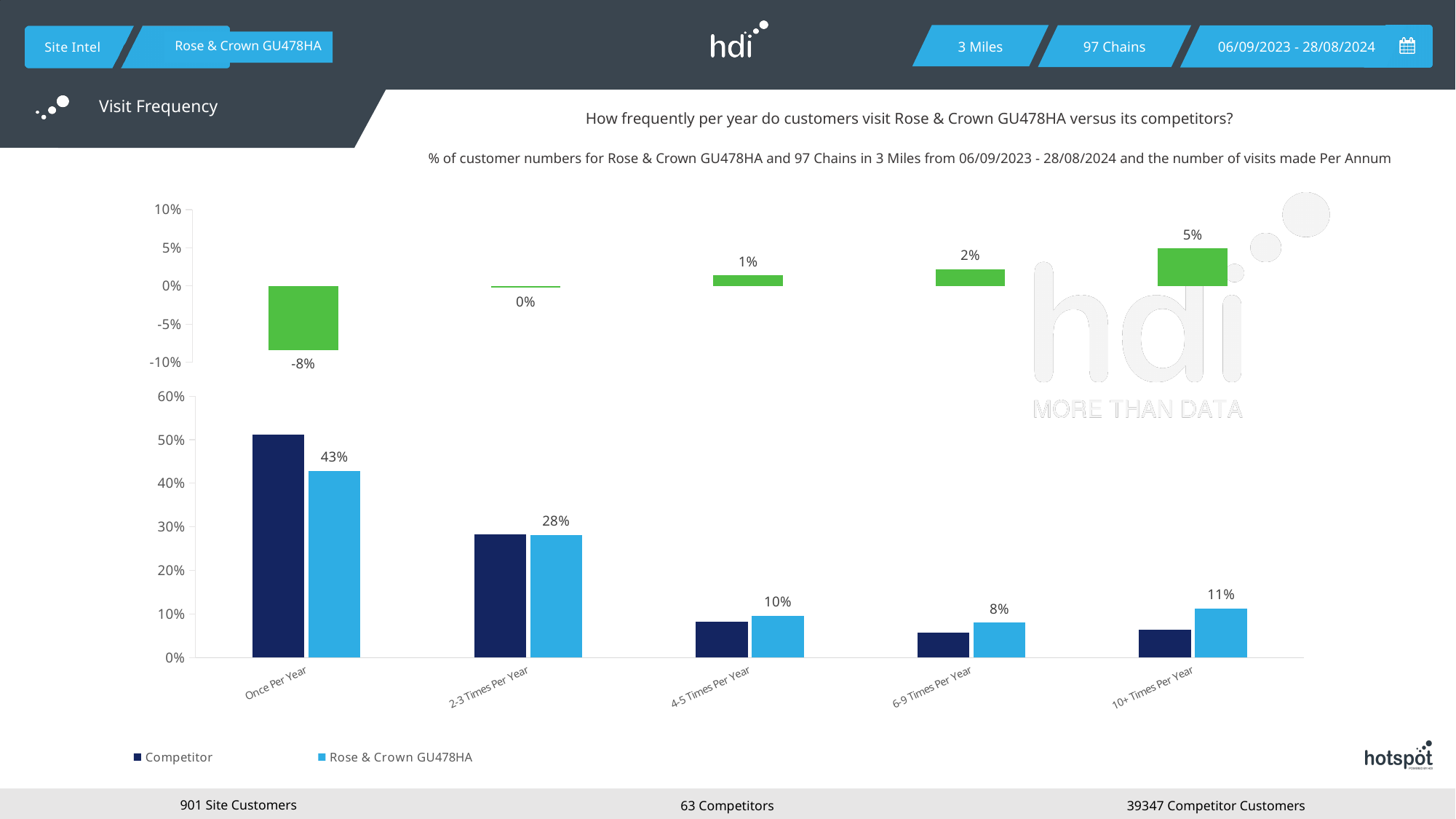
In the bottom chart, what is the difference between the Rose & Crown GU478HA values for Once Per Year and 2-3 Times Per Year? 15 percentage points In the top chart (green bars), what is the difference between the values for 10+ Times Per Year and 6-9 Times Per Year? 3 percentage points In the bottom chart, how many series does the legend list? 2 In the bottom chart, what is the value for Rose & Crown GU478HA in the Once Per Year category? 43% In the top chart (green bars), what is the value for Once Per Year? -8% In the bottom chart, is the Competitor value for Once Per Year greater or less than 50%? greater In the top chart (green bars), which category has the highest value? 10+ Times Per Year What kind of chart is the bottom chart? Bar chart In the bottom chart, which is larger for Once Per Year: Competitor or Rose & Crown GU478HA? Competitor In the bottom chart, how many categories are shown on the x axis? 5 In the top chart (green bars), which category has the lowest value? Once Per Year In the bottom chart, what is the value for Rose & Crown GU478HA in the 10+ Times Per Year category? 11%